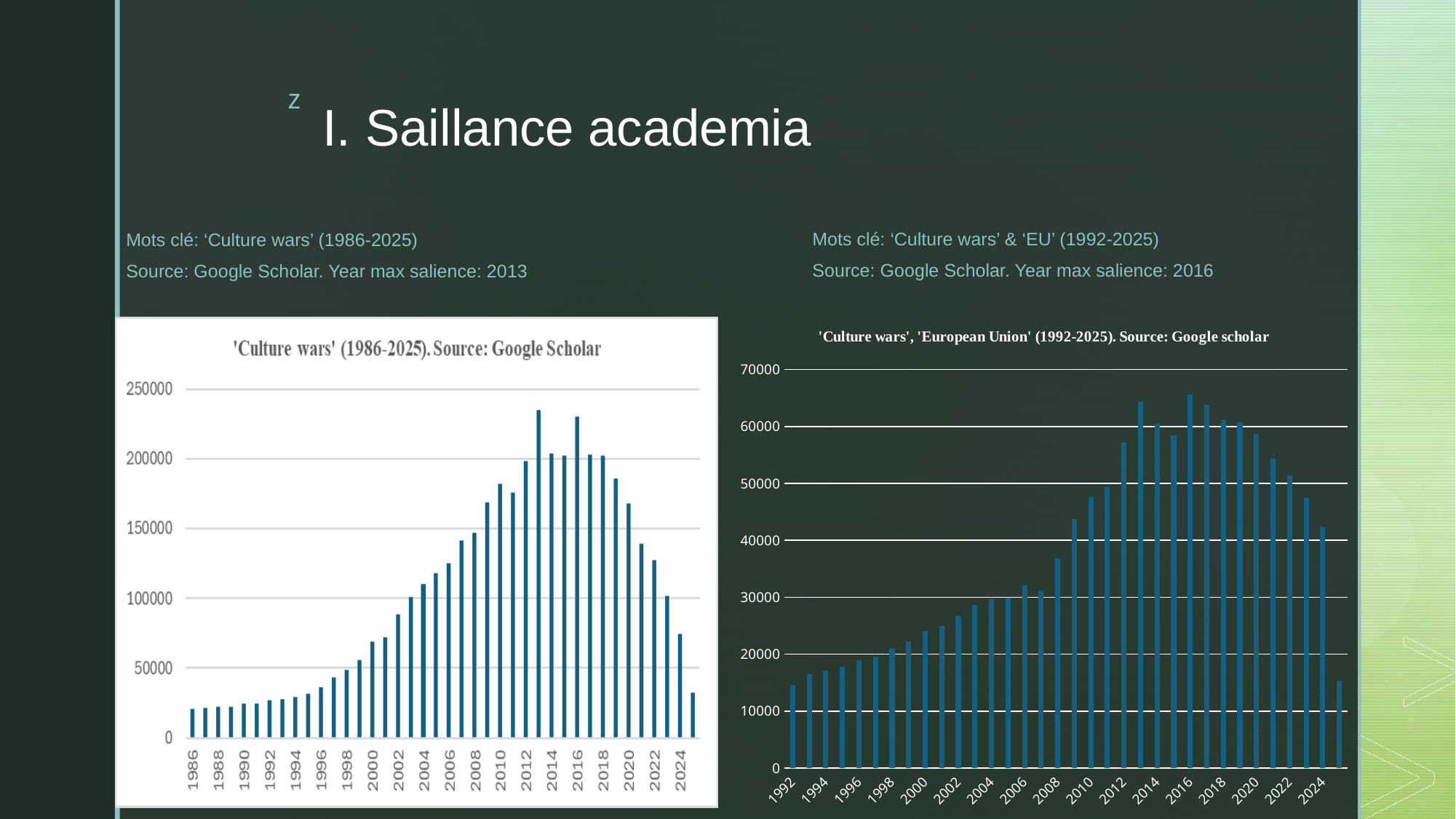
In the right chart, 'Culture wars', 'European Union' (1992-2025), do the values rise or fall from 1992 to 2016? rise In the left chart, 'Culture wars' (1986-2025), is the value for 1986 greater or less than 50000? less In the right chart, 'Culture wars', 'European Union' (1992-2025), is the value for 2016 greater or less than 60000? greater In the left chart, 'Culture wars' (1986-2025), which is larger, the value for 2013 or the value for 2024? 2013 In the left chart, 'Culture wars' (1986-2025), which year has the highest value? 2013 In the right chart, 'Culture wars', 'European Union' (1992-2025), which year has the highest value? 2016 In the left chart, 'Culture wars' (1986-2025), is the value for 2013 greater or less than 200000? greater What is the title of the chart on the right? 'Culture wars', 'European Union' (1992-2025). Source: Google scholar In the left chart, 'Culture wars' (1986-2025), do the values rise or fall from 2017 to 2025? fall In the right chart, 'Culture wars', 'European Union' (1992-2025), which is larger, the value for 2016 or the value for 2000? 2016 What kind of chart is the 'Culture wars' (1986-2025) chart on the left? bar chart